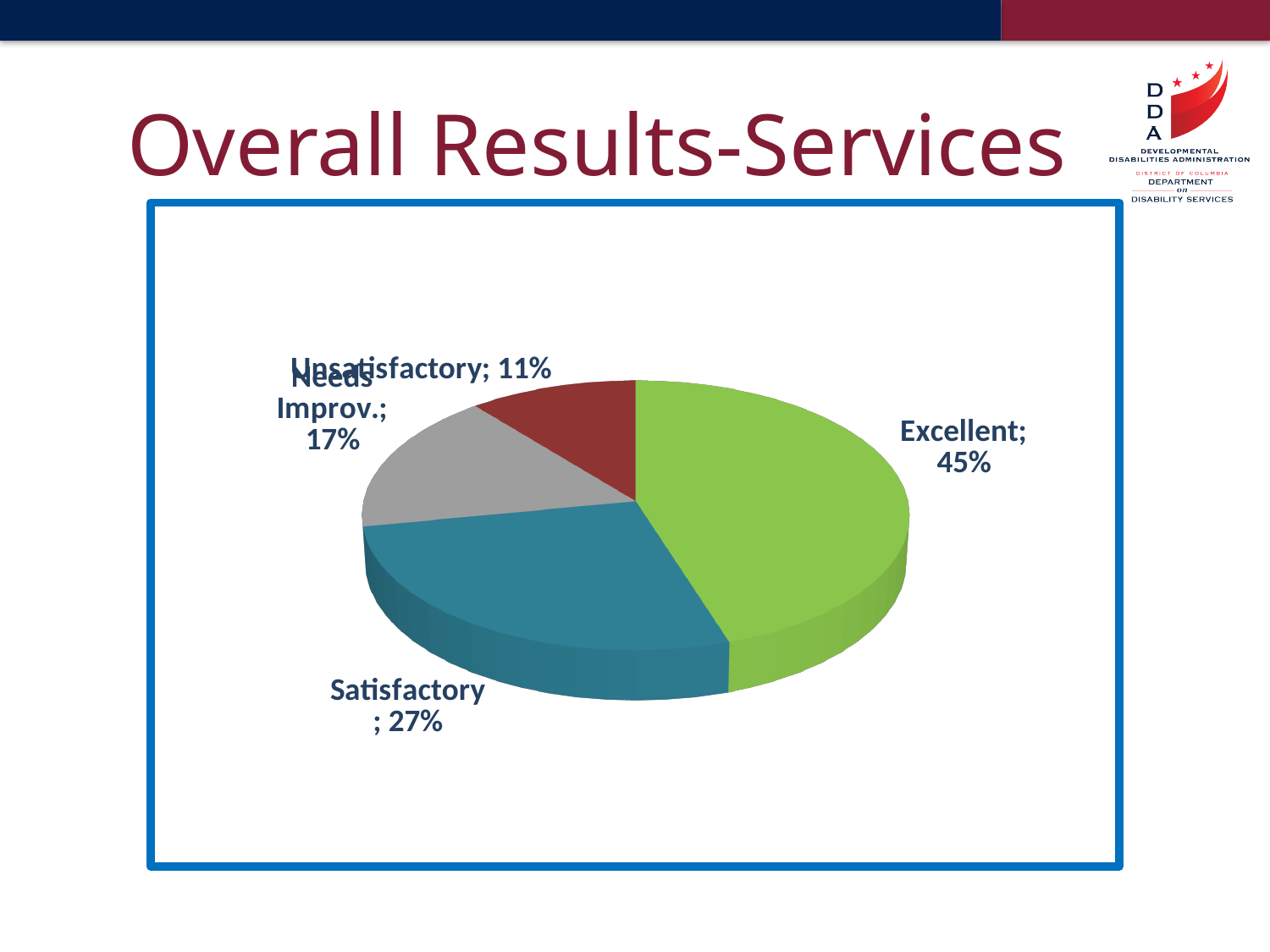
Which category has the smallest share of the pie? Unsatisfactory What percentage of the pie is labelled Satisfactory? 27% What percentage of the pie is labelled Unsatisfactory? 11% What percentage of the pie is labelled Needs Improv.? 17% What is the title of the slide containing the pie chart? Overall Results-Services What colour is the Excellent slice of the pie? green Which is larger, the share for Needs Improv. or the share for Unsatisfactory? Needs Improv. Which category has the largest share of the pie? Excellent What is the difference in percentage points between Excellent and Satisfactory? 18 How many slices does the pie chart have? 4 What percentage of the pie is labelled Excellent? 45% What type of chart is shown on the slide? pie chart